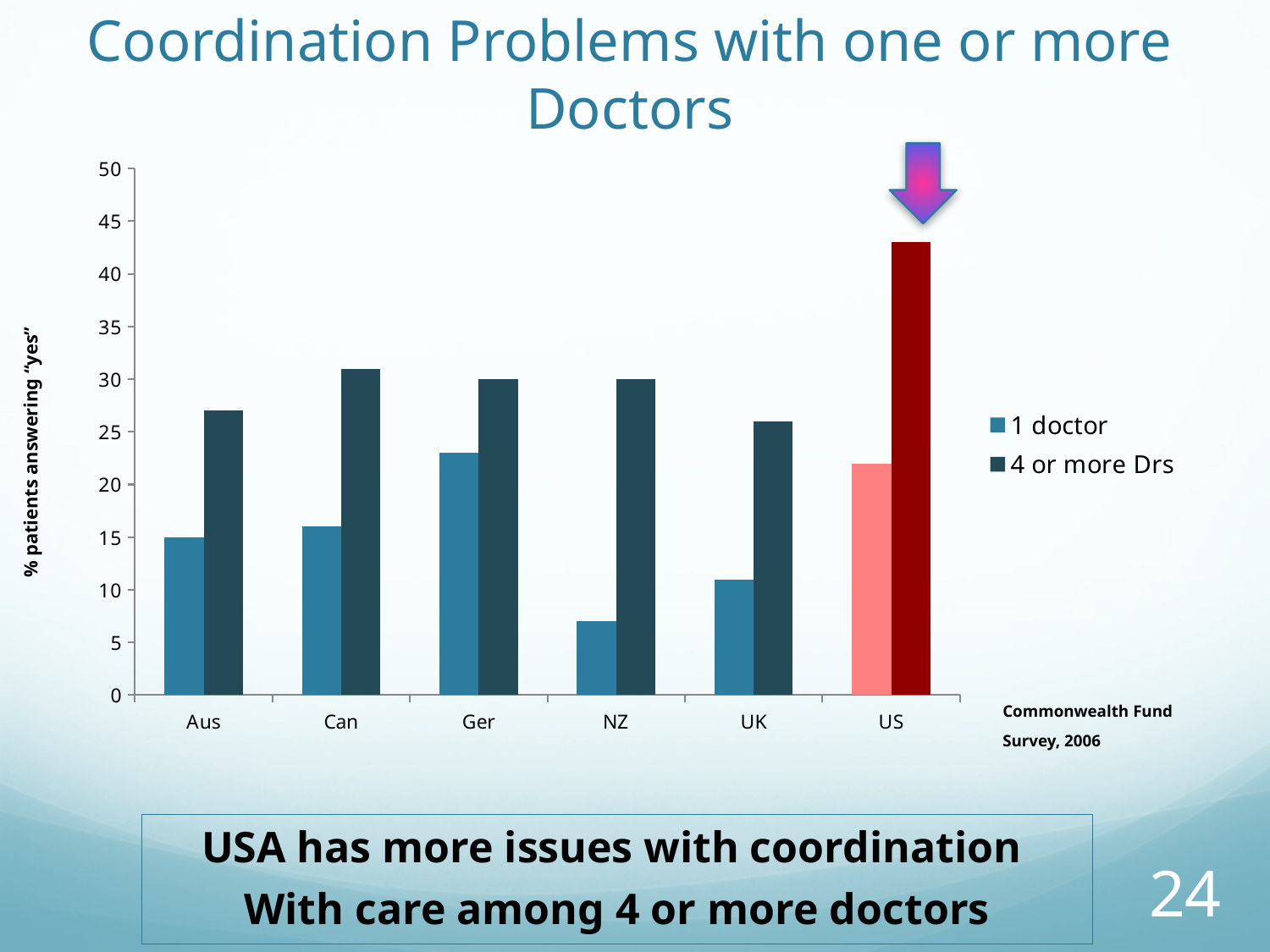
How many countries are shown on the x axis of the chart? 6 Is the '1 doctor' value for Ger greater or less than 20? greater What kind of chart is shown on the slide? bar chart Which country has the highest value for the '4 or more Drs' series? US Which is larger: the '1 doctor' value for Ger or the '1 doctor' value for Aus? Ger Which country has the lowest value for the '1 doctor' series? NZ Which is larger: the '4 or more Drs' value for Can or the '4 or more Drs' value for UK? Can Is the '4 or more Drs' value for UK greater or less than 30? less How many series does the chart's legend list? 2 Is the '4 or more Drs' value for US greater or less than 40? greater What is the label on the chart's vertical axis? % patients answering "yes"